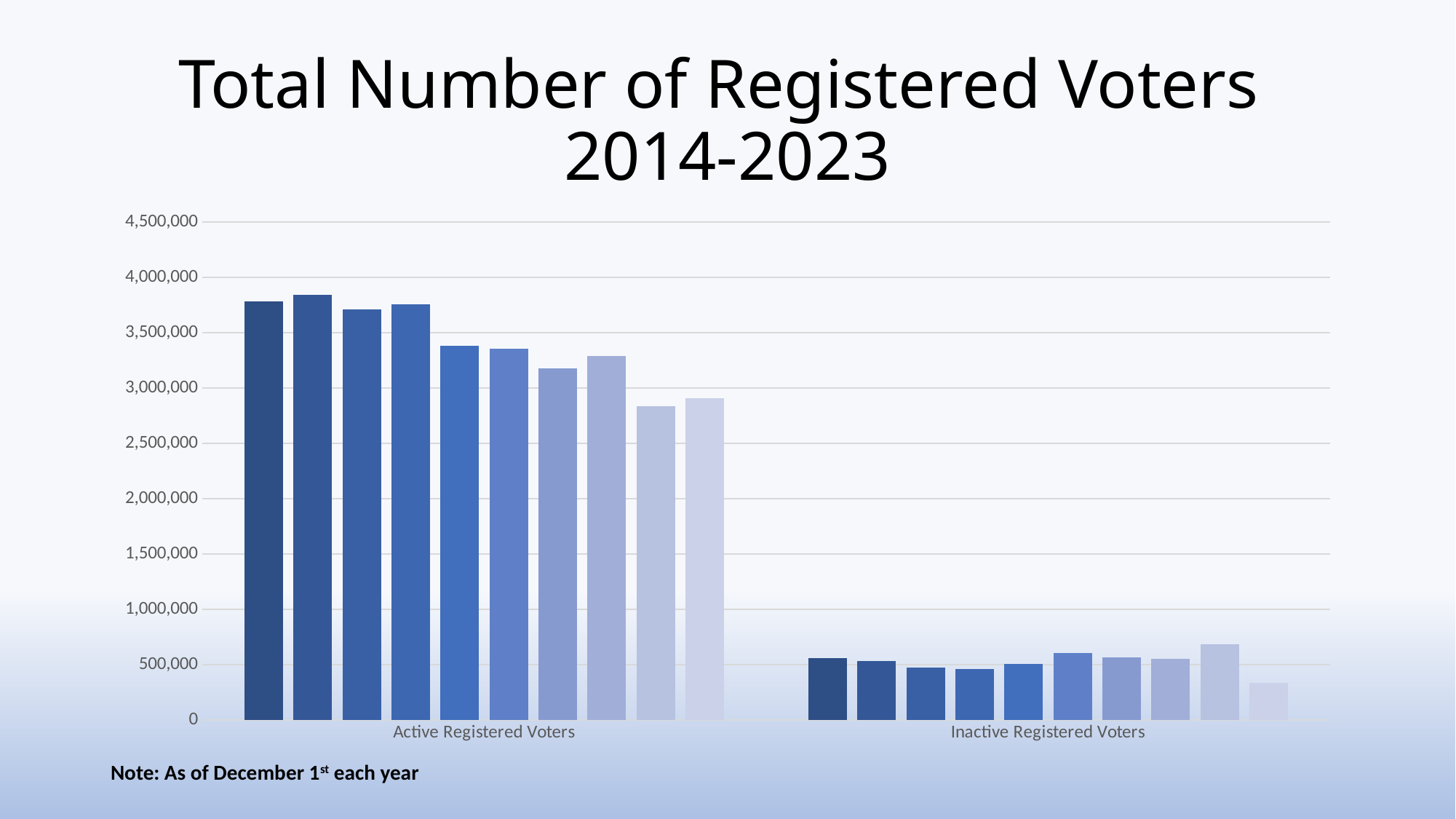
Is the value of the first bar in the Active Registered Voters group greater or less than 3,500,000? greater Is the value of the last bar in the Inactive Registered Voters group greater or less than 500,000? less Which bar in the Inactive Registered Voters group is the shortest? The last (tenth) bar What kind of chart is shown on the slide? Bar chart How many bars are plotted in the Active Registered Voters group? 10 Which category has the taller bars, Active Registered Voters or Inactive Registered Voters? Active Registered Voters Do the bars in the Active Registered Voters group generally rise or fall from left to right? fall Is the value of the tallest bar in the Inactive Registered Voters group greater or less than 500,000? greater What note appears below the chart? Note: As of December 1st each year How many categories are labelled on the horizontal axis? 2 What is the title of the chart? Total Number of Registered Voters 2014-2023